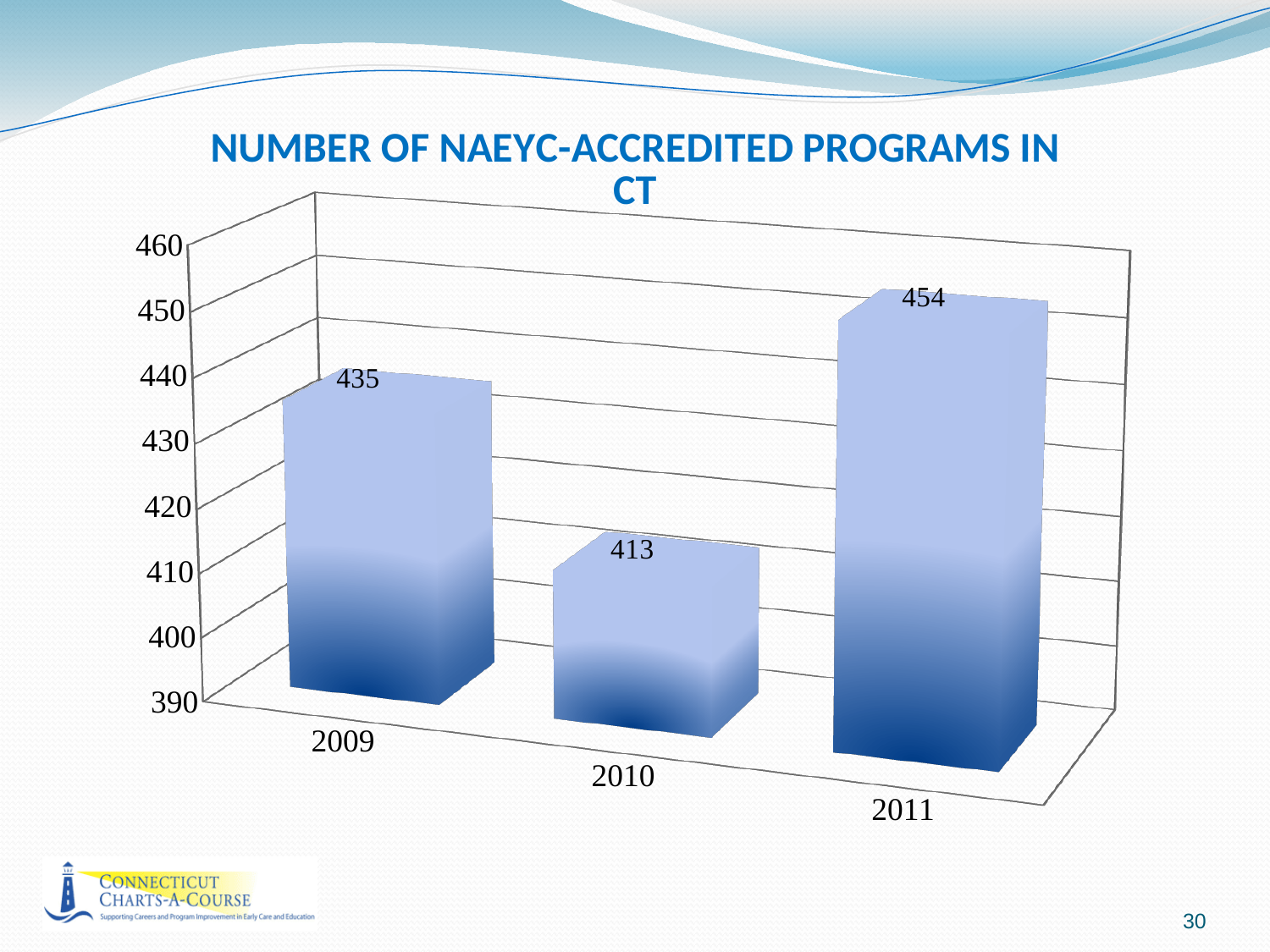
What is the difference between the number of programs in 2011 and in 2010? 41 Which year has the highest number of NAEYC-accredited programs? 2011 What is the number of NAEYC-accredited programs in CT in 2010? 413 How many years are shown on the chart? 3 What is the title of the chart? Number of NAEYC-Accredited Programs in CT Which year had more NAEYC-accredited programs, 2009 or 2011? 2011 Is the value for 2010 greater or less than 420? less What is the number of NAEYC-accredited programs in CT in 2009? 435 What is the difference between the number of programs in 2009 and in 2010? 22 What kind of chart is shown on the slide? Bar chart Which year has the lowest number of NAEYC-accredited programs? 2010 What is the number of NAEYC-accredited programs in CT in 2011? 454